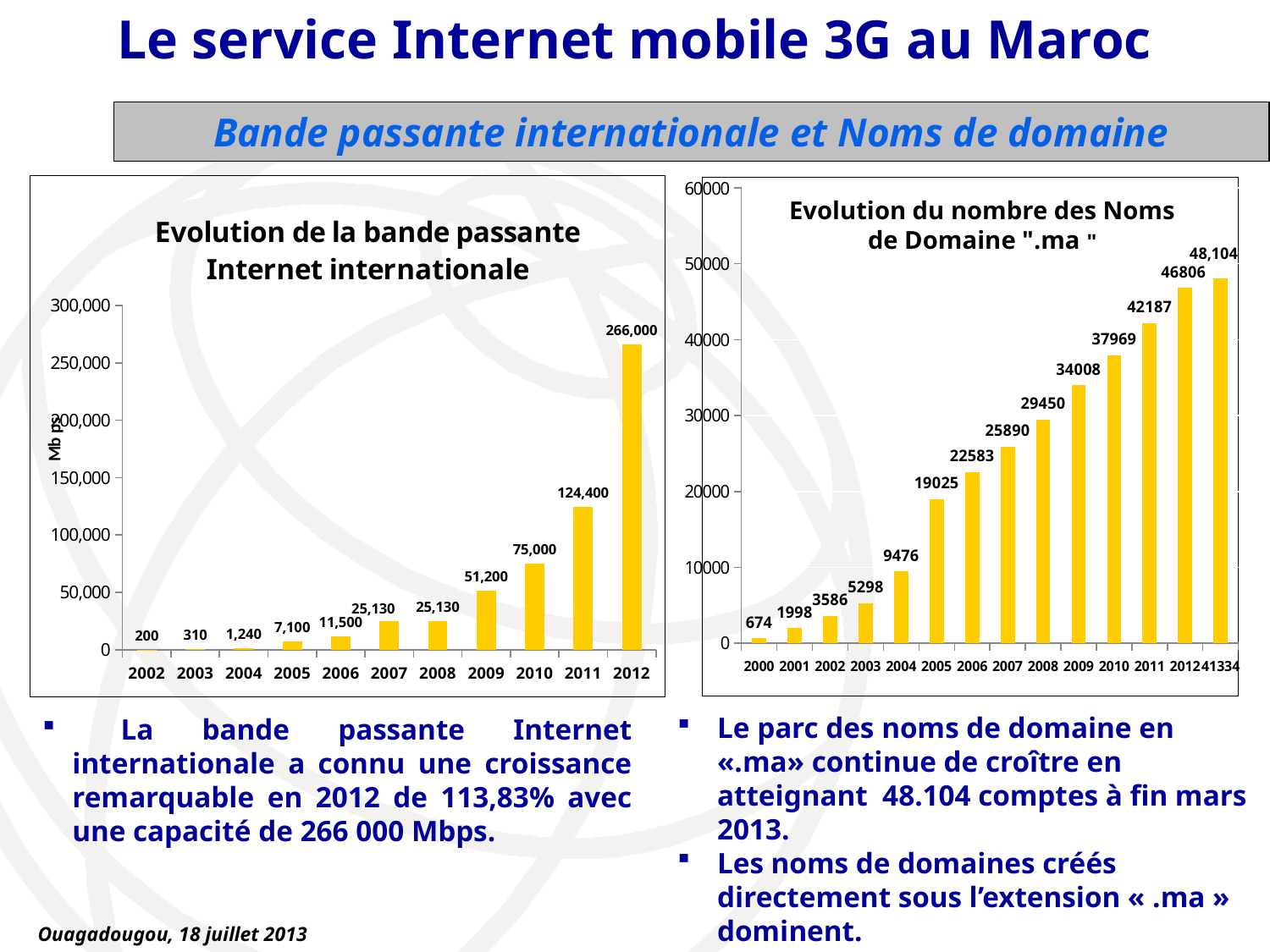
In the chart 'Evolution du nombre des Noms de Domaine ".ma"', do the values rise or fall from 2000 onwards? rise In the chart 'Evolution du nombre des Noms de Domaine ".ma"', what is the value for 2000? 674 In the chart 'Evolution de la bande passante Internet internationale', what is the value for 2009? 51,200 In the chart 'Evolution du nombre des Noms de Domaine ".ma"', what is the value for 2008? 29450 In the chart 'Evolution de la bande passante Internet internationale', what is the difference between the values for 2012 and 2011? 141,600 In the chart 'Evolution du nombre des Noms de Domaine ".ma"', what is the difference between the values for 2005 and 2004? 9549 In the chart 'Evolution de la bande passante Internet internationale', which year has the lowest value? 2002 In the chart 'Evolution de la bande passante Internet internationale', how many years are plotted? 11 What type of chart is 'Evolution du nombre des Noms de Domaine ".ma"'? bar chart In the chart 'Evolution de la bande passante Internet internationale', what is the label on the vertical axis? Mbps In the chart 'Evolution de la bande passante Internet internationale', what is the value for 2012? 266,000 In the chart 'Evolution du nombre des Noms de Domaine ".ma"', which is larger, the value for 2010 or the value for 2009? 2010